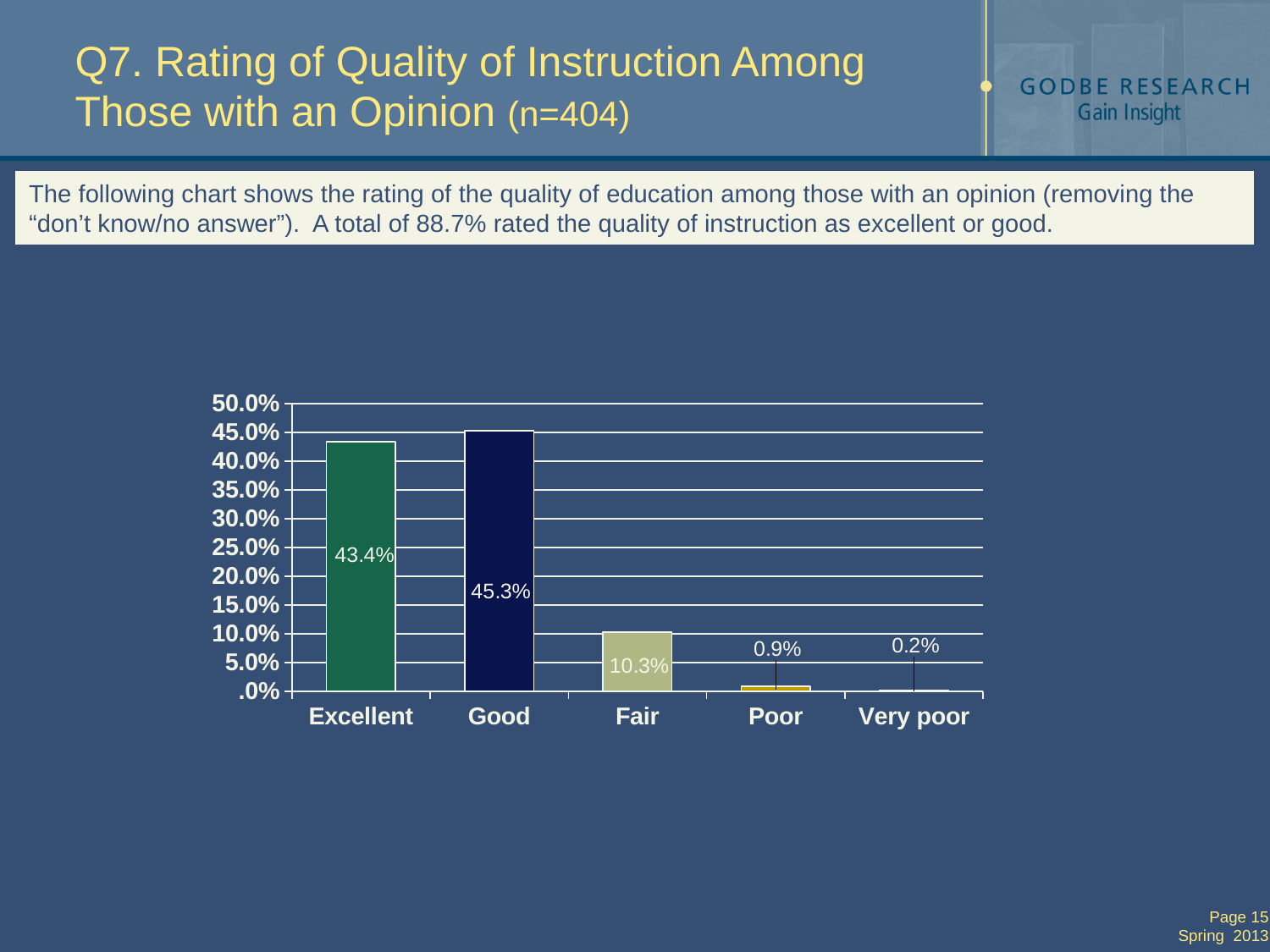
Which rating category has the highest value? Good What is the difference between the Fair and Poor values? 9.4% How many rating categories are shown on the x axis? 5 What is the value shown for the Good rating? 45.3% What percentage of respondents rated the quality of instruction as Excellent? 43.4% What is the value for the Very poor category? 0.2% Which rating category has the lowest value? Very poor What is the difference between the Good and Excellent values? 1.9% What kind of chart is shown on the slide? Bar chart What percentage rated the quality of instruction as Fair? 10.3% Which is larger, the value for Fair or the value for Poor? Fair Is the value for Excellent greater or less than 40.0%? greater